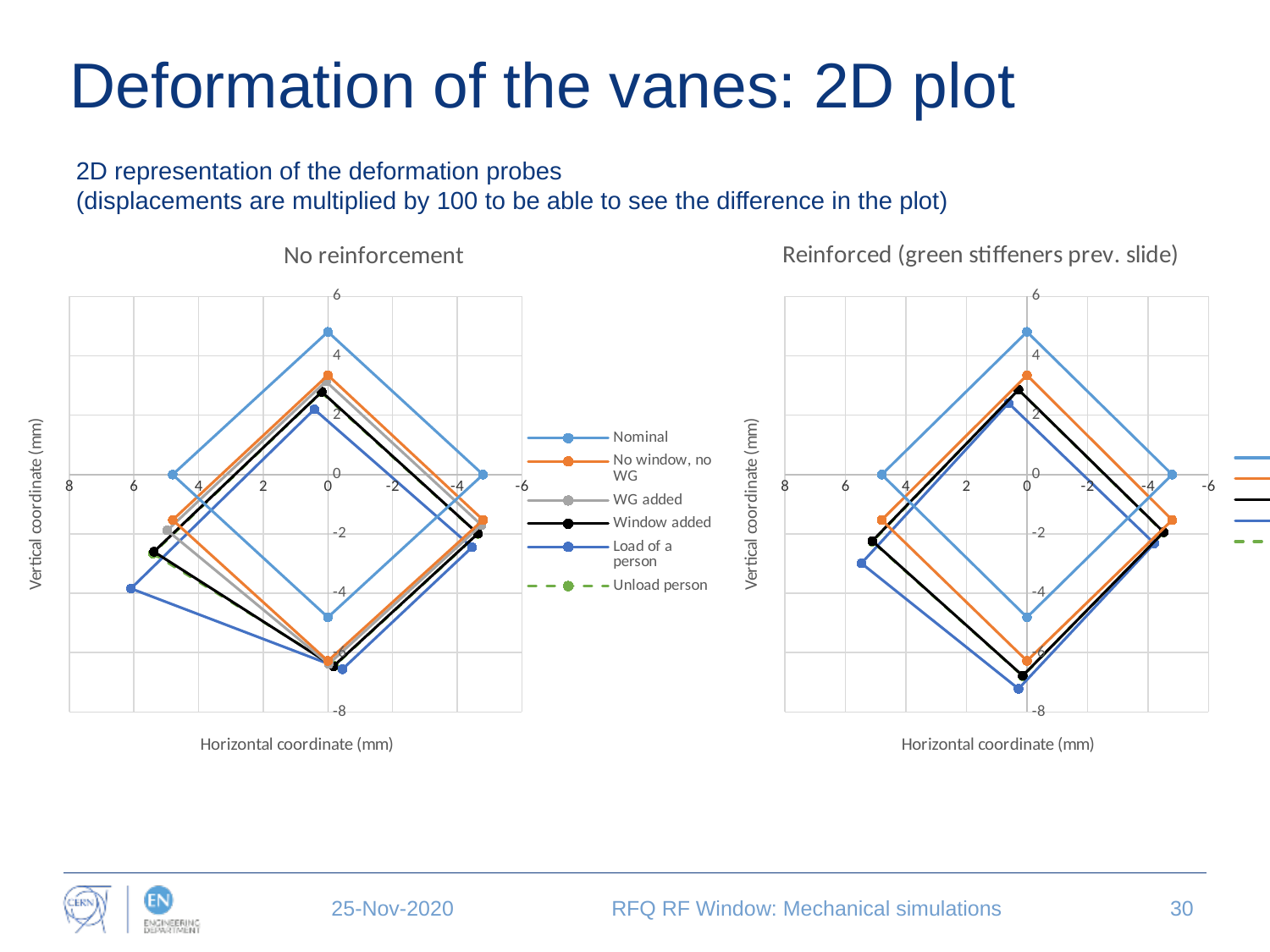
What kind of chart is the 'No reinforcement' chart? Scatter (line) chart In the 'No reinforcement' chart, is the vertical coordinate of the lowest Nominal point greater or less than -4? less In the 'Reinforced (green stiffeners prev. slide)' chart, is the vertical coordinate of the topmost Nominal point greater or less than 4? greater In the 'Reinforced (green stiffeners prev. slide)' chart, is the vertical coordinate of the lowest 'Load of a person' point greater or less than -6? less How many charts are shown on the slide? 2 What is the title of the right-hand chart? Reinforced (green stiffeners prev. slide) How many series does the legend of the 'No reinforcement' chart list? 6 What is the label of the vertical axis on the 'No reinforcement' chart? Vertical coordinate (mm) In the 'No reinforcement' chart, which series reaches the higher vertical coordinate at its top point: Nominal or Load of a person? Nominal